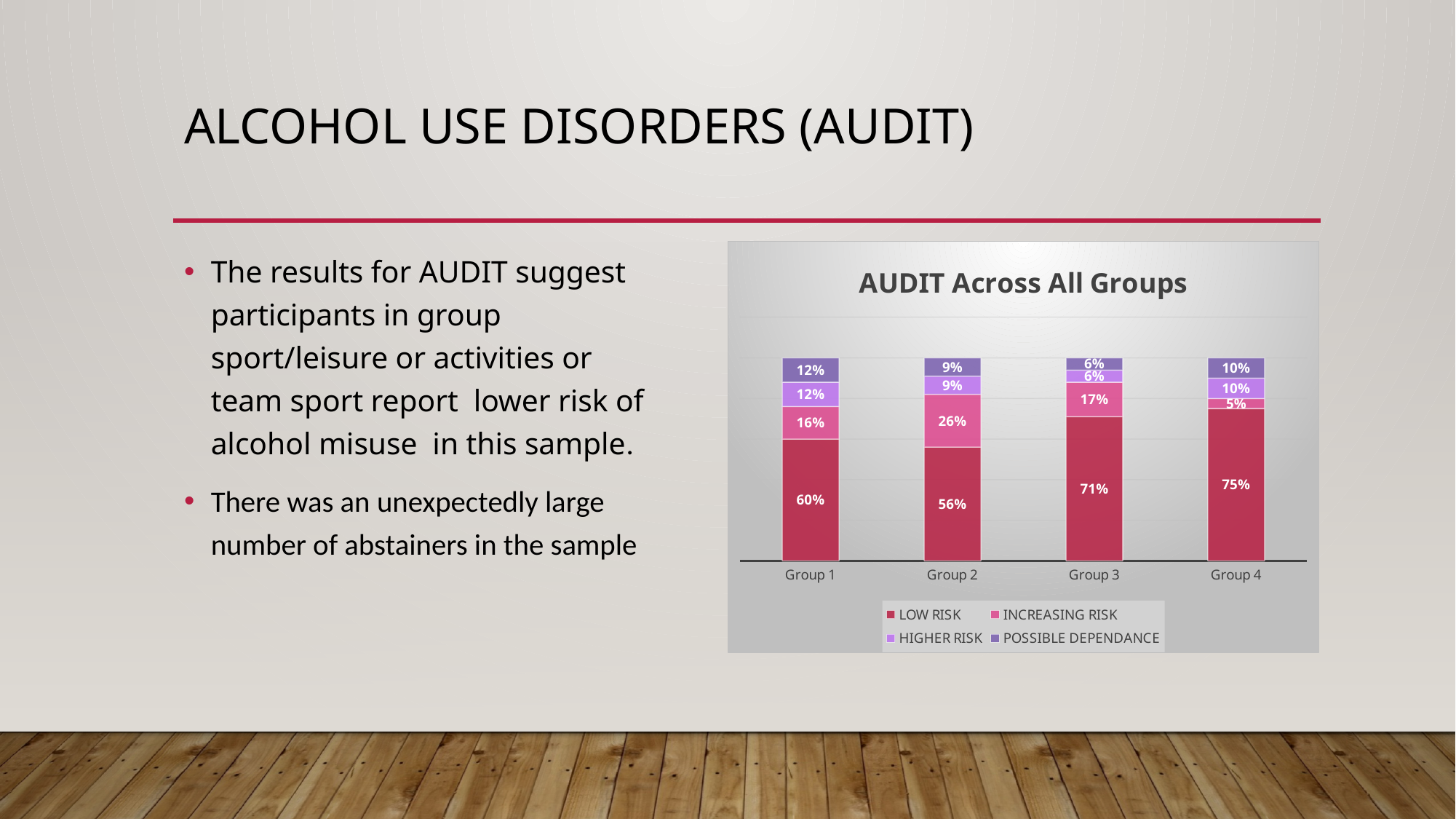
What is the HIGHER RISK value for Group 4? 10% What is the INCREASING RISK value for Group 2? 26% What is the title of the chart? AUDIT Across All Groups How many groups are shown on the x axis? 4 Which group has the highest LOW RISK value? Group 4 How many series does the legend list? 4 Which group has the lowest LOW RISK value? Group 2 What is the POSSIBLE DEPENDANCE value for Group 1? 12% What kind of chart is shown? Stacked bar chart What is the LOW RISK value for Group 3? 71% What is the difference between the LOW RISK values for Group 4 and Group 2? 19% Which is larger, the INCREASING RISK value for Group 1 or for Group 3? Group 3